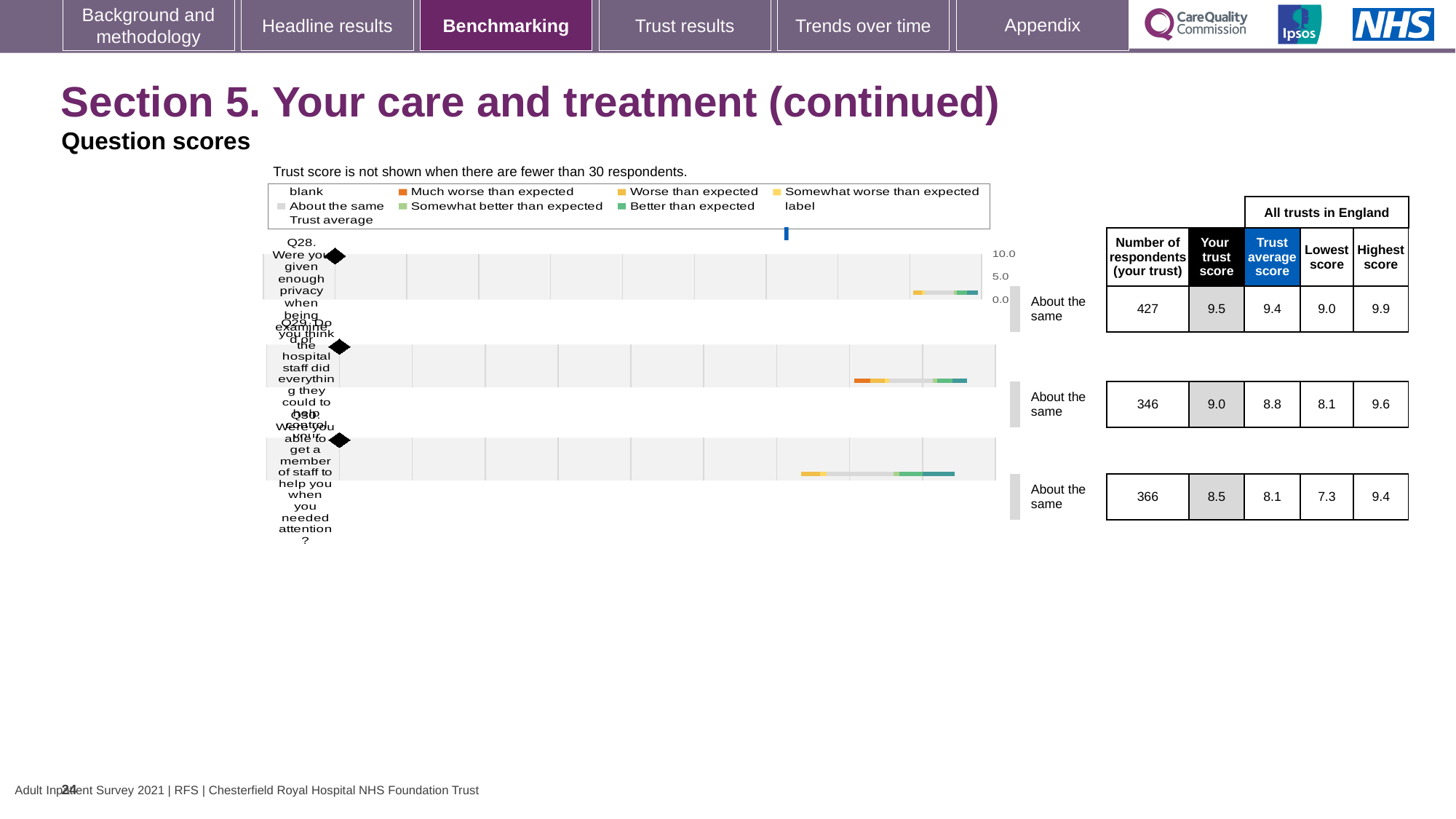
What kind of chart is used to show the benchmarking results for Q28, Q29 and Q30? Bar chart How many respondents from the trust answered Q28? 427 What is the trust average score for Q29 (Do you think the hospital staff did everything they could to help control your pain)? 8.8 For Q29, which is larger: the trust score or the trust average score? Trust score What benchmarking category is shown for Q30? About the same Which of the three questions has the lowest trust score? Q30 How many questions (Q28, Q29, Q30) are shown with benchmarking charts on this slide? 3 Which of the three questions has the highest trust score? Q28 What is the maximum value shown on the score axis of the charts? 10.0 What is the lowest score across all trusts in England for Q30 (Were you able to get a member of staff to help you when you needed attention)? 7.3 What is the trust score for Q28 (Were you given enough privacy when being examined or treated)? 9.5 What is the difference between the highest score and the lowest score for Q30? 2.1